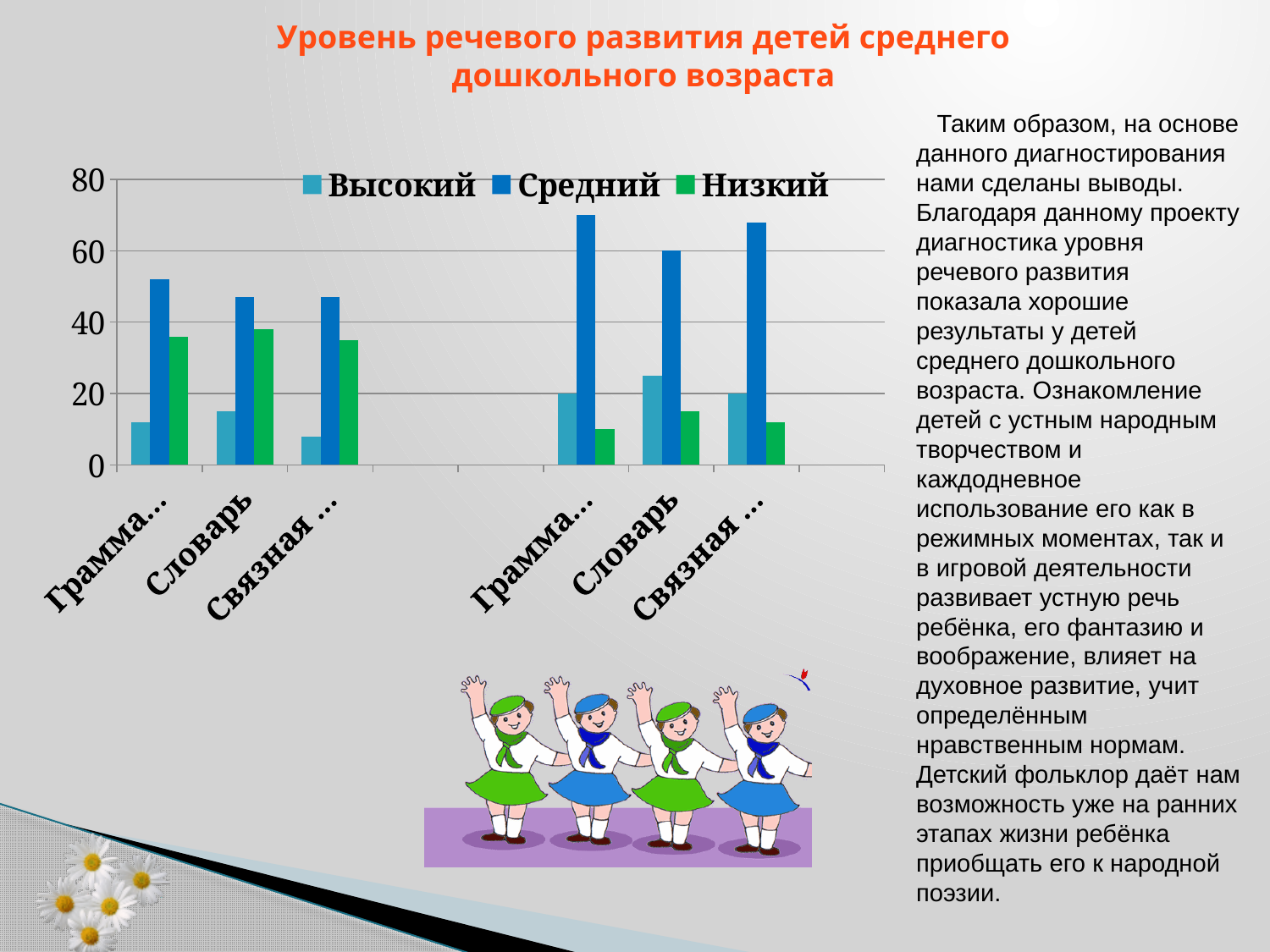
How many category labels are shown along the x axis of the chart? 6 In the left-hand group of the chart, which series has the lowest value for Словарь? Высокий In the right-hand group of the chart, which is larger for Словарь: the Средний value or the Низкий value? Средний In the right-hand group of the chart, is the Средний value for Словарь greater or less than 40? greater Which series is shown in green in the chart? Низкий In the left-hand group of the chart, is the Низкий value for Словарь greater or less than 20? greater In the right-hand group of the chart, is the Низкий value for Словарь greater or less than 20? less In the right-hand group of the chart, which series has the highest value for Словарь? Средний What kind of chart is shown on the slide? bar chart How many series does the chart legend list? 3 What are the three series named in the chart legend? Высокий, Средний, Низкий